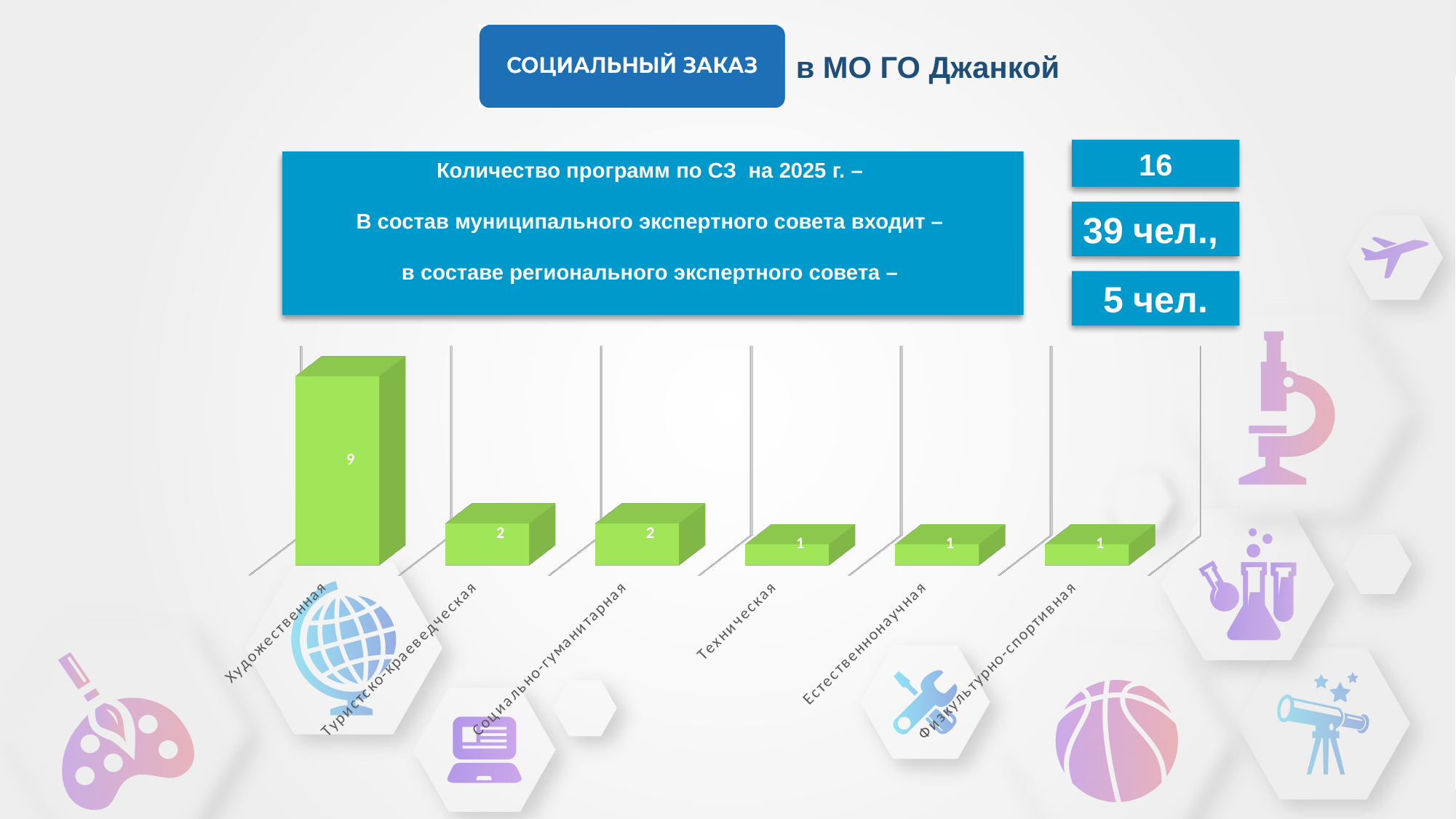
What is the value for Туристско-краеведческая? 2 What is the value for Физкультурно-спортивная? 1 What kind of chart is shown on the slide? bar chart Do the values rise or fall from left to right across the categories? fall What is the value for Художественная? 9 Which is larger, the value for Туристско-краеведческая or the value for Естественнонаучная? Туристско-краеведческая What is the total of all the bar values in the chart? 16 How many categories are shown in the chart? 6 Which category has the highest value? Художественная What colour are the bars in the chart? green What is the difference between the values for Художественная and Социально-гуманитарная? 7 What is the value for Техническая? 1